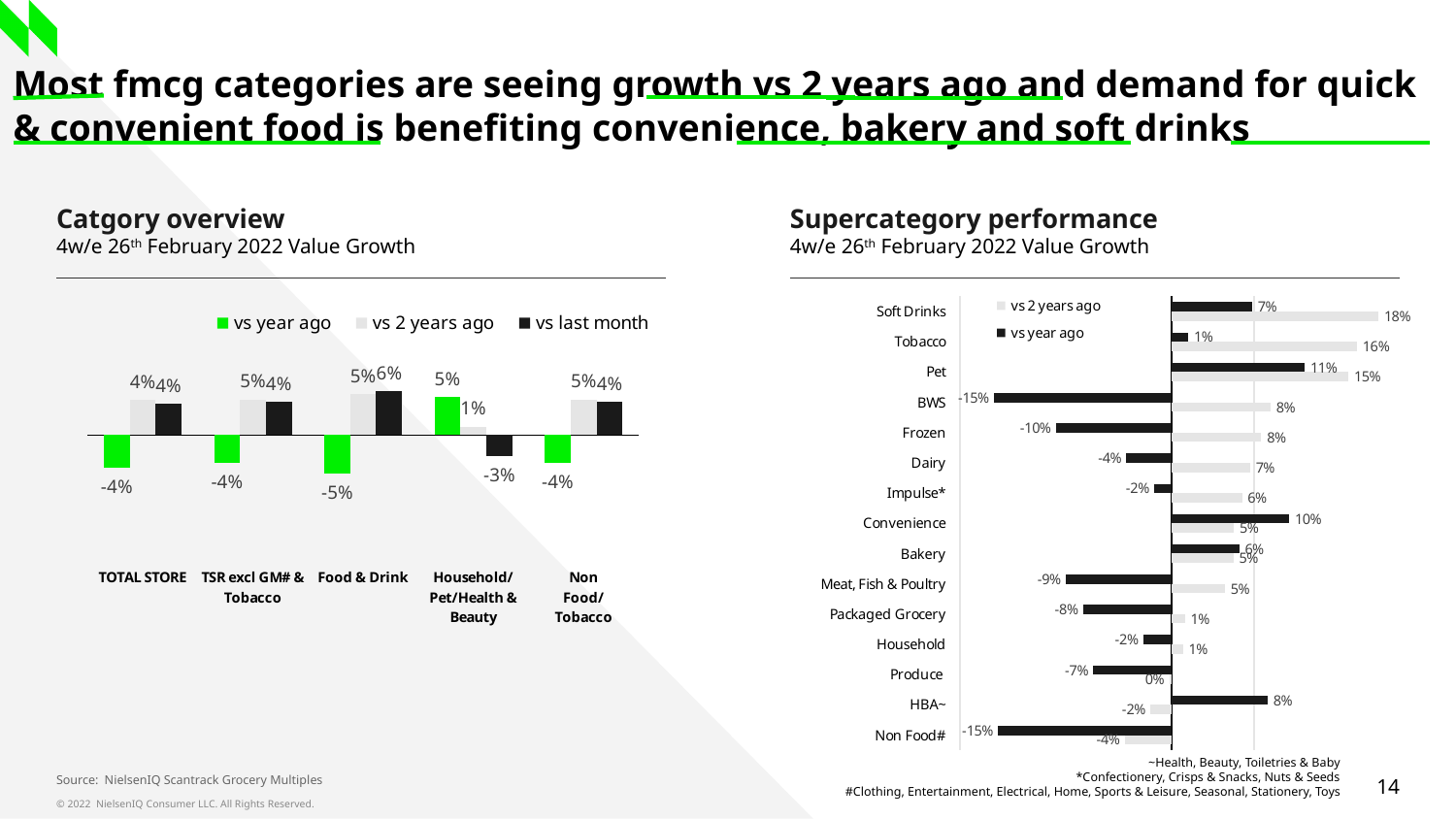
What kind of chart is the Supercategory performance chart? Bar chart How many supercategories are shown in the Supercategory performance chart? 15 In the Supercategory performance chart, what is the vs 2 years ago value for Soft Drinks? 18% In the Supercategory performance chart, which supercategory has the lowest vs 2 years ago value? Non Food# In the Supercategory performance chart, what is the vs year ago value for BWS? -15% How many series does the legend of the Catgory overview chart list? 3 In the Supercategory performance chart, which is larger for Convenience: the vs year ago value or the vs 2 years ago value? vs year ago In the Catgory overview chart, what is the vs last month value for Food & Drink? 6% In the Supercategory performance chart, what is the difference between the vs 2 years ago and vs year ago values for Tobacco? 15% In the Catgory overview chart, what is the vs year ago value for Household/Pet/Health & Beauty? 5% In the Catgory overview chart, which category has the lowest vs year ago value? Food & Drink In the Supercategory performance chart, which supercategory has the highest vs 2 years ago value? Soft Drinks